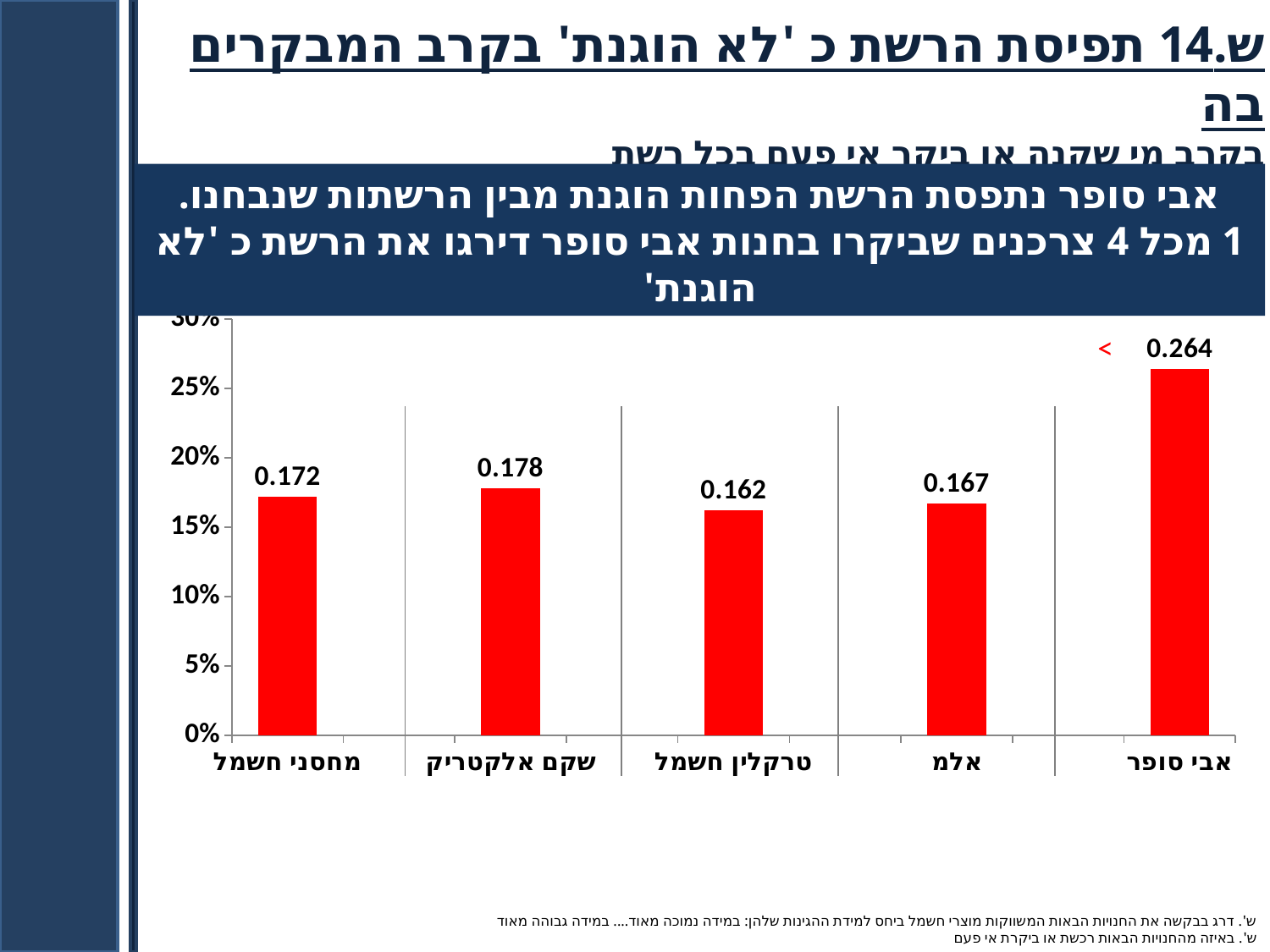
What value is shown for טרקלין חשמל? 0.162 Which category has the lowest value? טרקלין חשמל What colour are the bars in the chart? red Is the value for אבי סופר greater or less than 25%? greater Which category has the highest value? אבי סופר What is the difference between the values for אבי סופר and אלמ? 0.097 What value is shown for מחסני חשמל? 0.172 Which is larger, the value for שקם אלקטריק or the value for מחסני חשמל? שקם אלקטריק What kind of chart is shown on the slide? bar chart What value is shown for אבי סופר? 0.264 How many categories are shown on the x axis? 5 What value is shown for שקם אלקטריק? 0.178